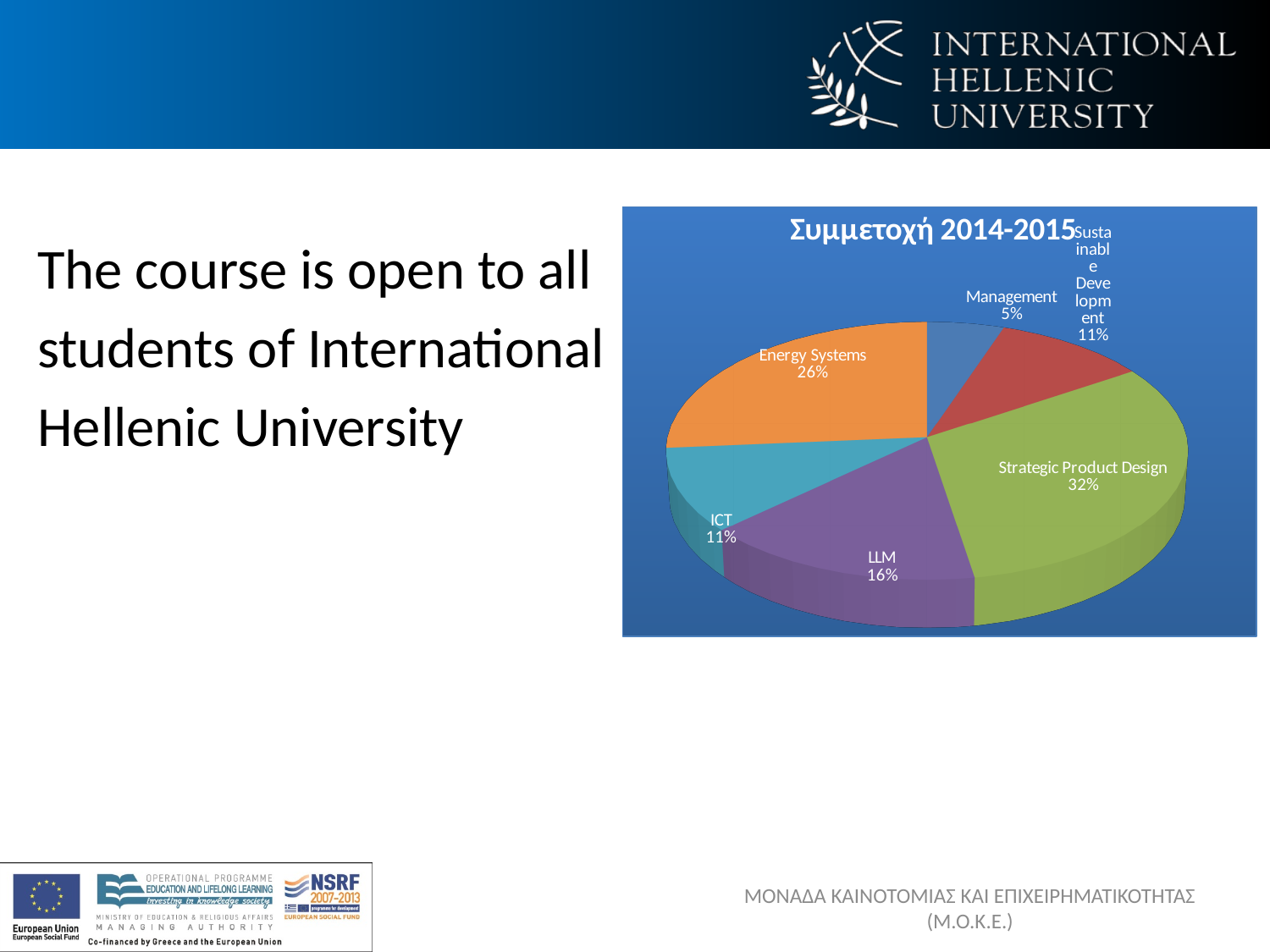
What percentage is shown for Management? 5% What percentage is shown for LLM? 16% What is the title of the chart? Συμμετοχή 2014-2015 Which category has the largest slice of the pie? Strategic Product Design What share of the pie does Strategic Product Design have? 32% How many categories are shown in the pie chart? 6 Which is larger, the share for LLM or the share for ICT? LLM What share of the pie does Energy Systems have? 26% Which category has the smallest slice of the pie? Management What kind of chart is shown on the slide? Pie chart What is the difference in percentage points between Strategic Product Design and Energy Systems? 6 What percentage is shown for ICT? 11%